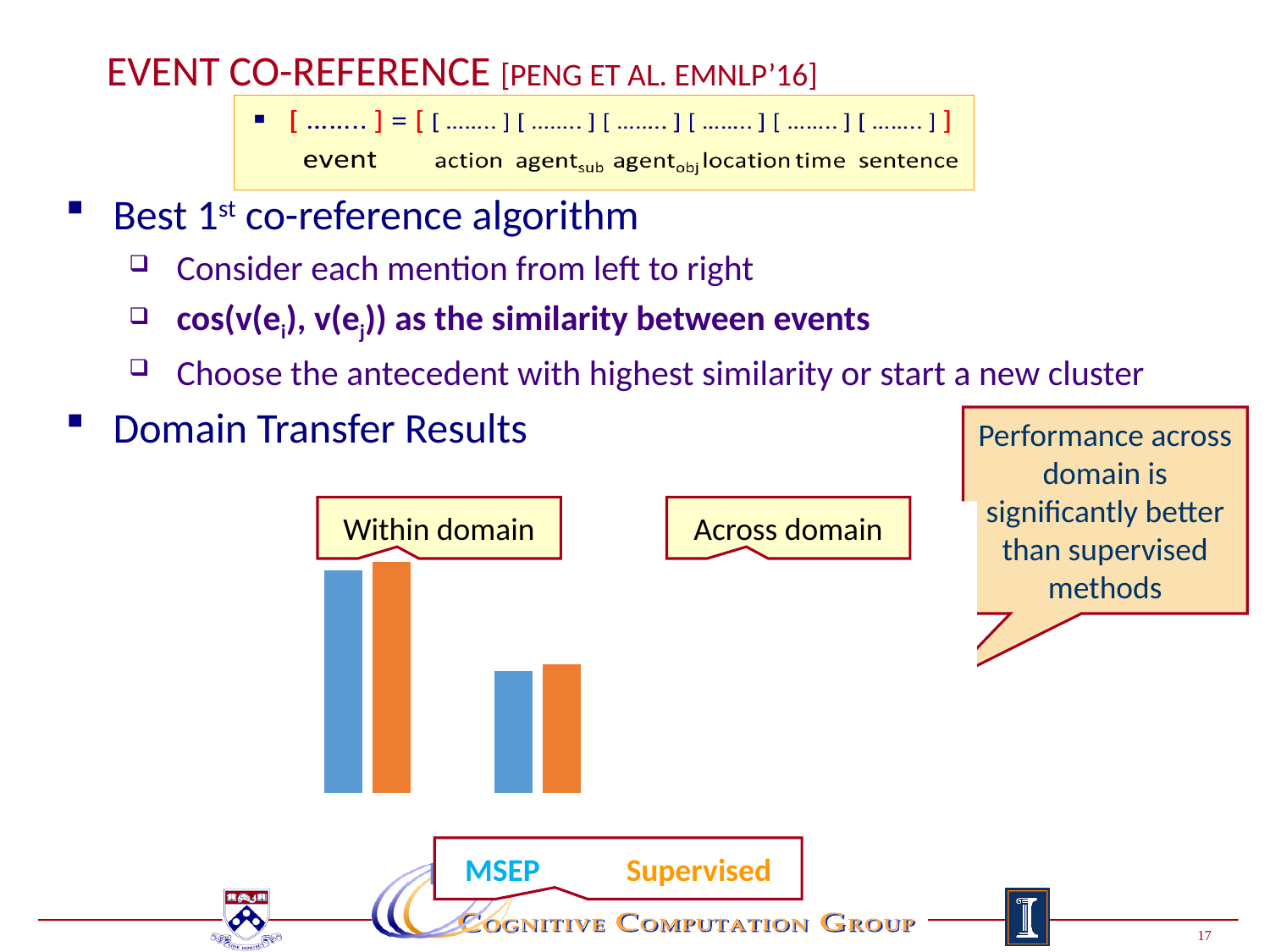
What are the two series named in the legend of the Domain Transfer Results chart? MSEP and Supervised In the Domain Transfer Results chart, which category has the lowest bars overall? Across domain In the Domain Transfer Results chart, is the Supervised bar larger for Within domain or Across domain? Within domain In the Domain Transfer Results chart, do the bar heights rise or fall going from Within domain to Across domain? fall How many categories (groups of bars) does the Domain Transfer Results chart show? 2 In the Domain Transfer Results chart, which category has the highest bars overall? Within domain In the Domain Transfer Results chart, is the MSEP bar larger for Within domain or Across domain? Within domain How many series does the legend of the Domain Transfer Results chart list? 2 What kind of chart is shown under "Domain Transfer Results"? bar chart What are the two categories shown on the x axis of the Domain Transfer Results chart? Within domain and Across domain